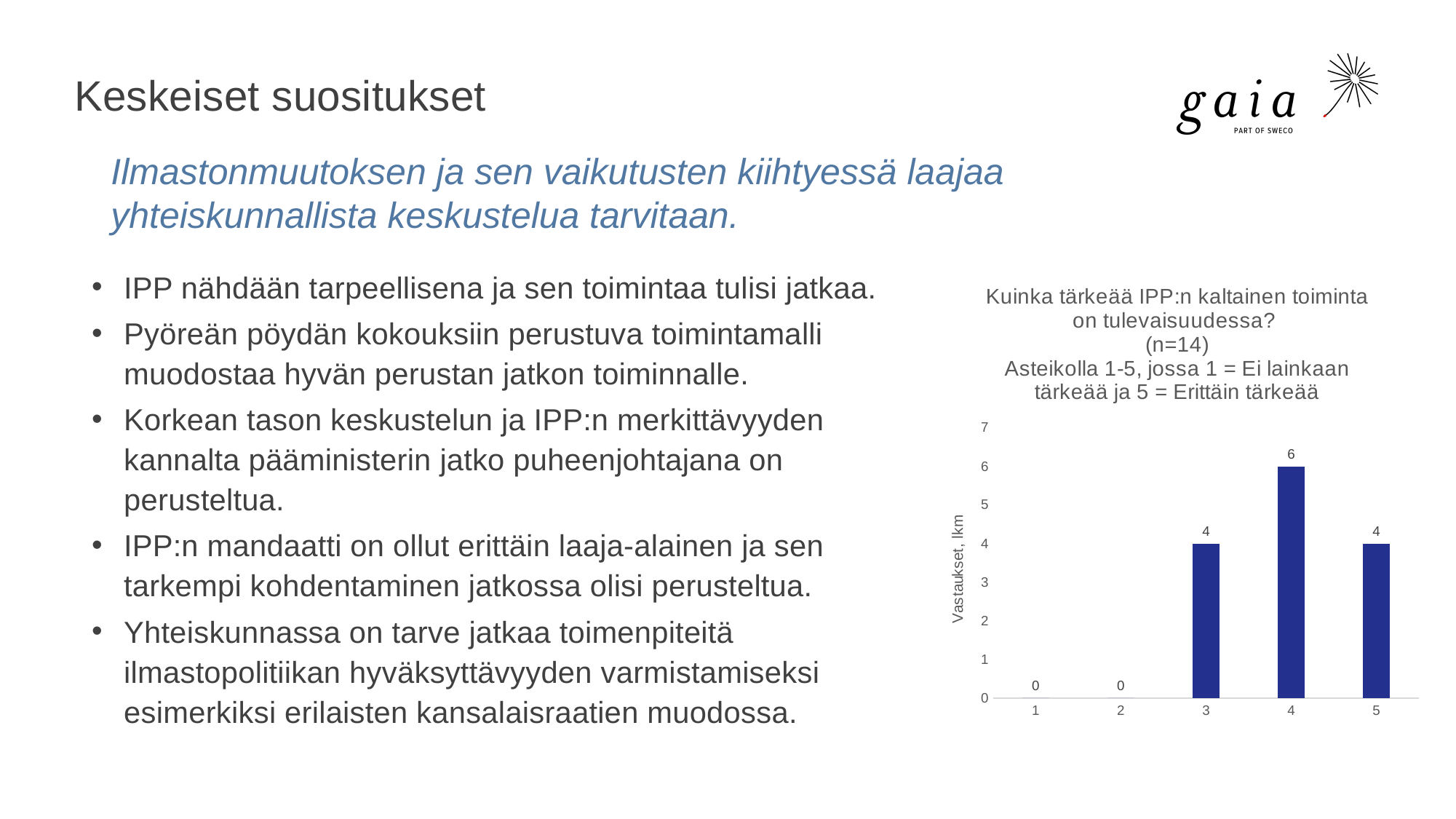
What is the y-axis label of the chart? Vastaukset, lkm Which category has the highest value in the chart? 4 What is the difference between the values for category 4 and category 5? 2 What is the value for category 3 in the chart? 4 What is the total of the values for categories 3, 4 and 5? 14 Is the value for category 4 greater or less than 5? greater How many categories are shown on the x axis of the chart? 5 What is the value for category 1 in the chart? 0 What is the value for category 4 in the chart? 6 How many respondents (n) does the chart title state? 14 Which is larger, the value for category 3 or the value for category 4? category 4 What kind of chart is shown on the slide? bar chart